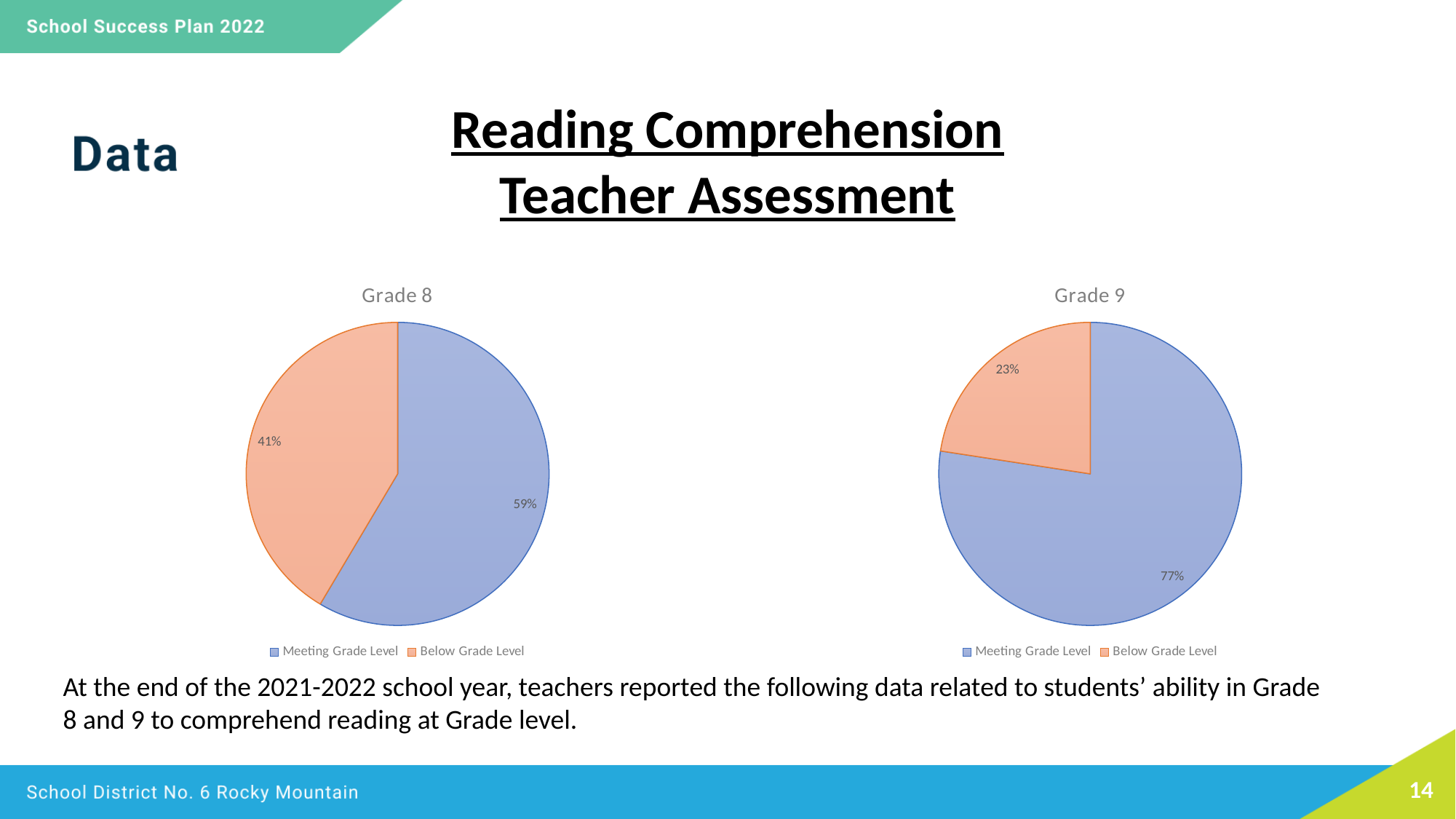
In the Grade 8 chart, what is the difference between the Meeting Grade Level and Below Grade Level percentages? 18% In the Grade 8 chart, what percentage of students are Below Grade Level? 41% In the Grade 8 chart, what colour is the Below Grade Level slice? Orange In the Grade 9 chart, what is the difference between the Meeting Grade Level and Below Grade Level percentages? 54% In the Grade 9 chart, which category has the largest slice? Meeting Grade Level What kind of chart is the Grade 8 chart? Pie chart How many slices does the Grade 9 pie chart have? 2 In the Grade 8 chart, which category has the smallest slice? Below Grade Level Which chart shows a larger Meeting Grade Level share, Grade 8 or Grade 9? Grade 9 In the Grade 9 chart, what percentage of students are Meeting Grade Level? 77% In the Grade 9 chart, what percentage of students are Below Grade Level? 23% In the Grade 8 chart, what percentage of students are Meeting Grade Level? 59%